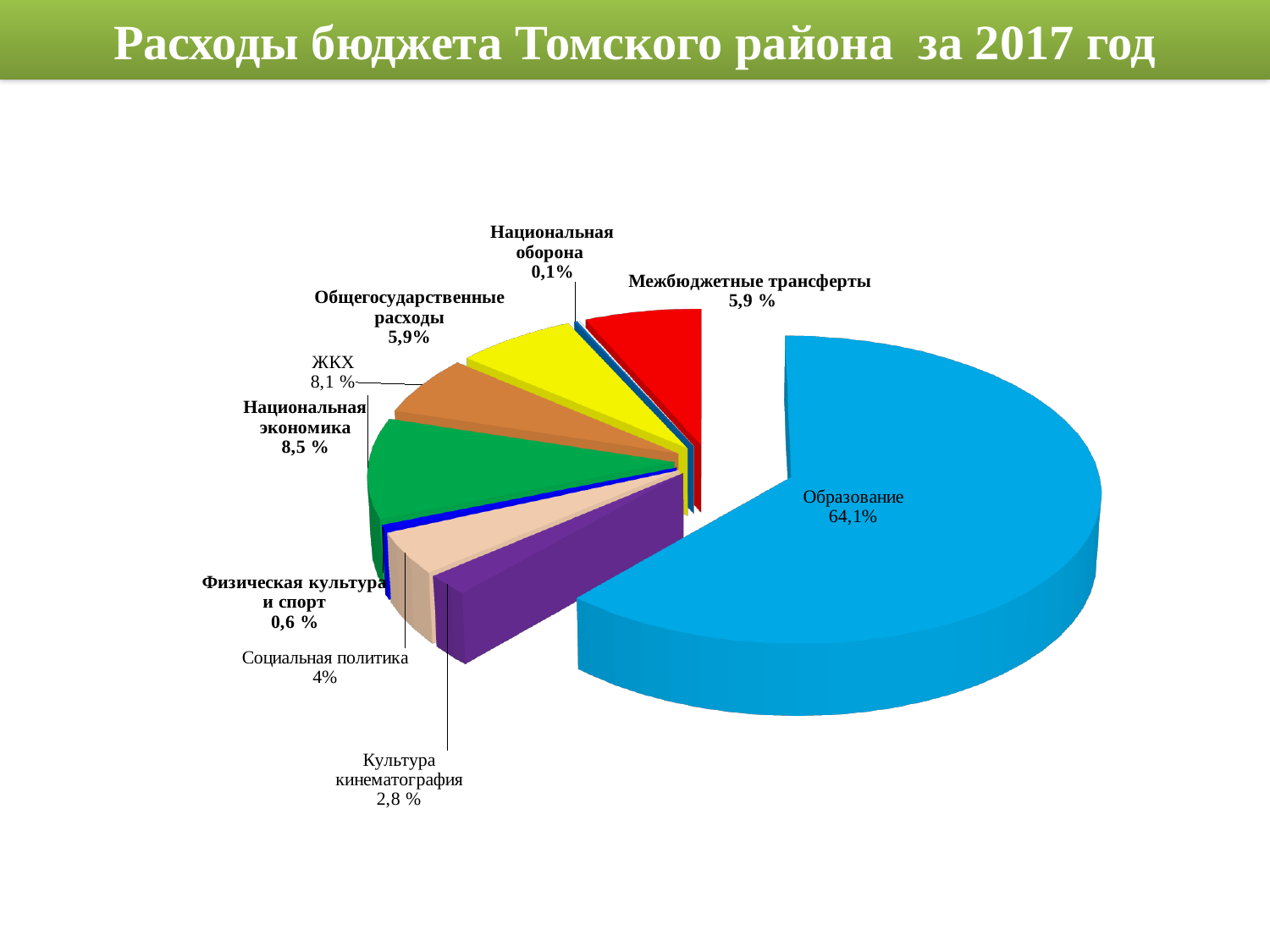
What is the title of the chart on the slide? Расходы бюджета Томского района за 2017 год What share of the pie does Образование have? 64,1% How many categories are shown in the pie chart? 9 Which category has the smallest slice of the pie? Национальная оборона What is the value shown for Социальная политика? 4% What kind of chart is shown on the slide? Pie chart What is the difference in percentage points between Образование and Национальная экономика? 55,6 Which is larger, Национальная экономика or ЖКХ? Национальная экономика What is the value shown for Национальная экономика? 8,5 % What is the value shown for ЖКХ? 8,1 % What is the value shown for Культура кинематография? 2,8 % Which category has the largest slice of the pie? Образование